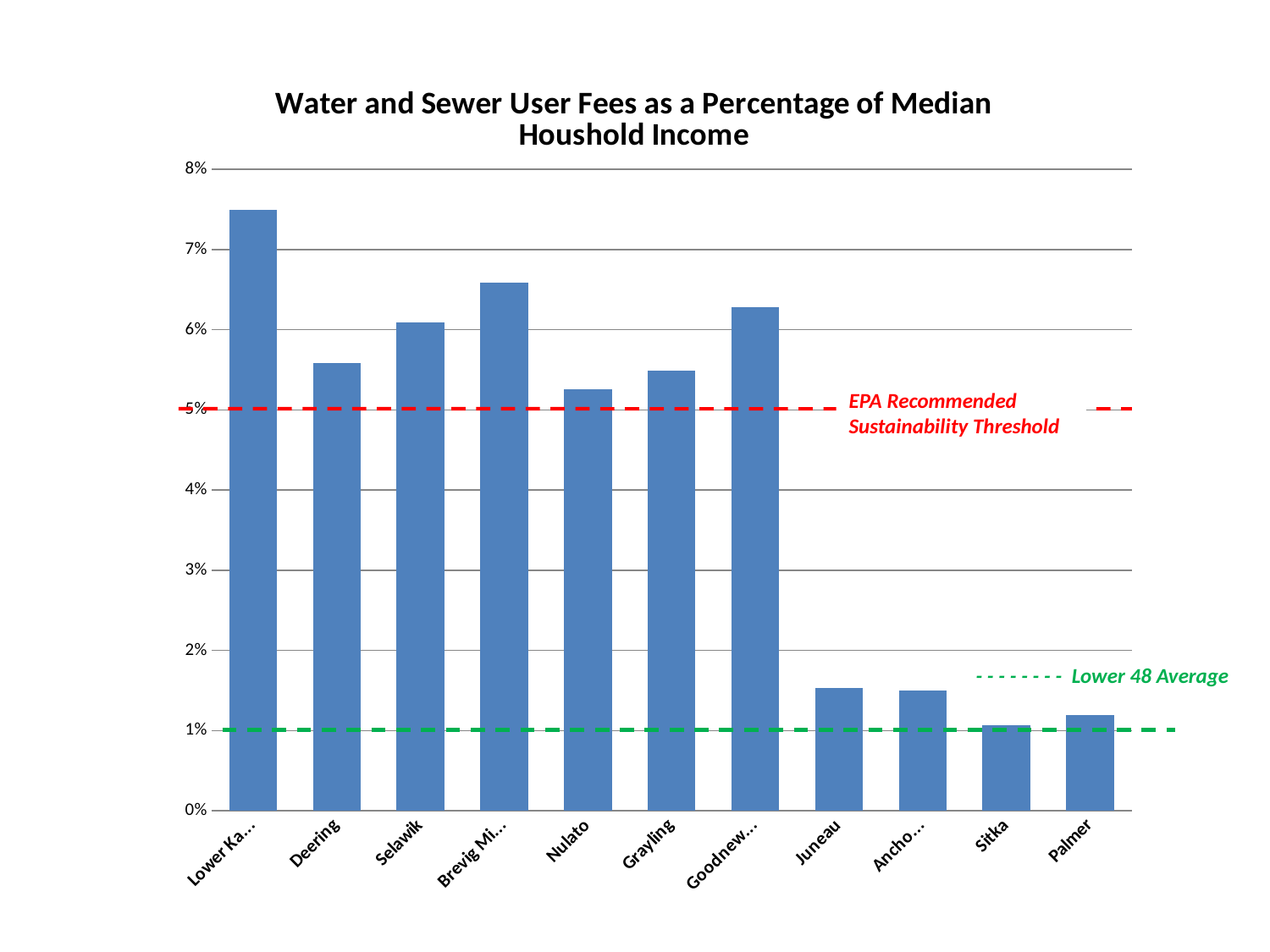
What kind of chart is shown on the slide? bar chart How many communities (bars) are plotted in the chart? 11 Which is higher, the value for Juneau or the value for Sitka? Juneau Is the value for Nulato greater or less than 5%? greater What does the red dashed line in the chart represent? EPA Recommended Sustainability Threshold Which is higher, the value for Deering or the value for Selawik? Selawik Is the value for Deering greater or less than 5%? greater Which community has the lowest water and sewer user fees as a percentage of median household income? Sitka Is the value for Juneau greater or less than 2%? less What does the green dashed line in the chart represent? Lower 48 Average